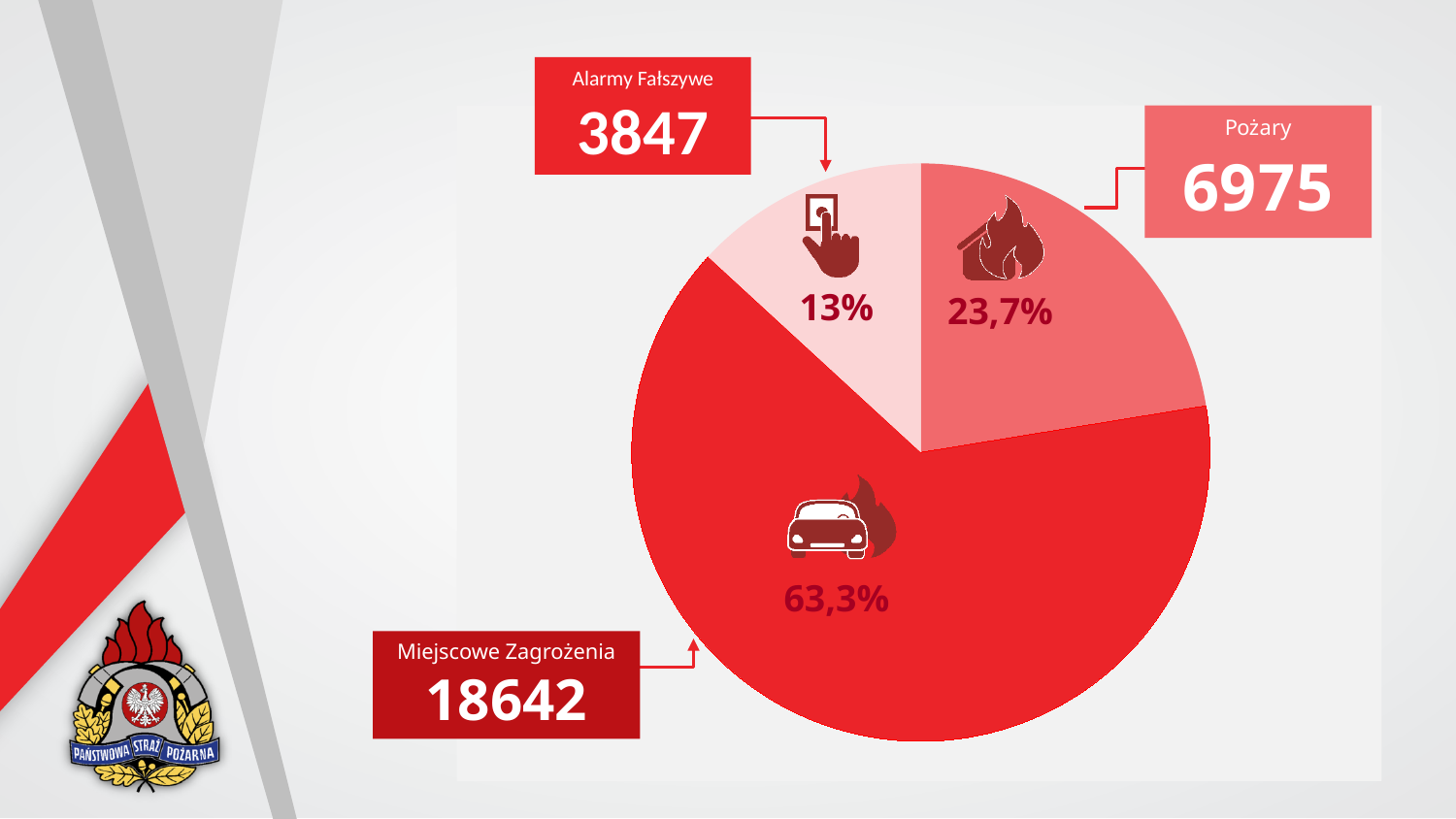
How many categories does the pie chart show? 3 What share of the pie does Pożary represent? 23,7% Which category has the largest slice of the pie? Miejscowe Zagrożenia What is the value shown for Pożary? 6975 What is the difference between the values for Miejscowe Zagrożenia and Pożary? 11667 What share of the pie does Miejscowe Zagrożenia represent? 63,3% What is the value shown for Miejscowe Zagrożenia? 18642 What is the total of the three values shown on the pie chart? 29464 What is the value shown for Alarmy Fałszywe? 3847 Which is larger, the value for Pożary or the value for Alarmy Fałszywe? Pożary What kind of chart is shown on the slide? pie chart Which category has the smallest slice of the pie? Alarmy Fałszywe